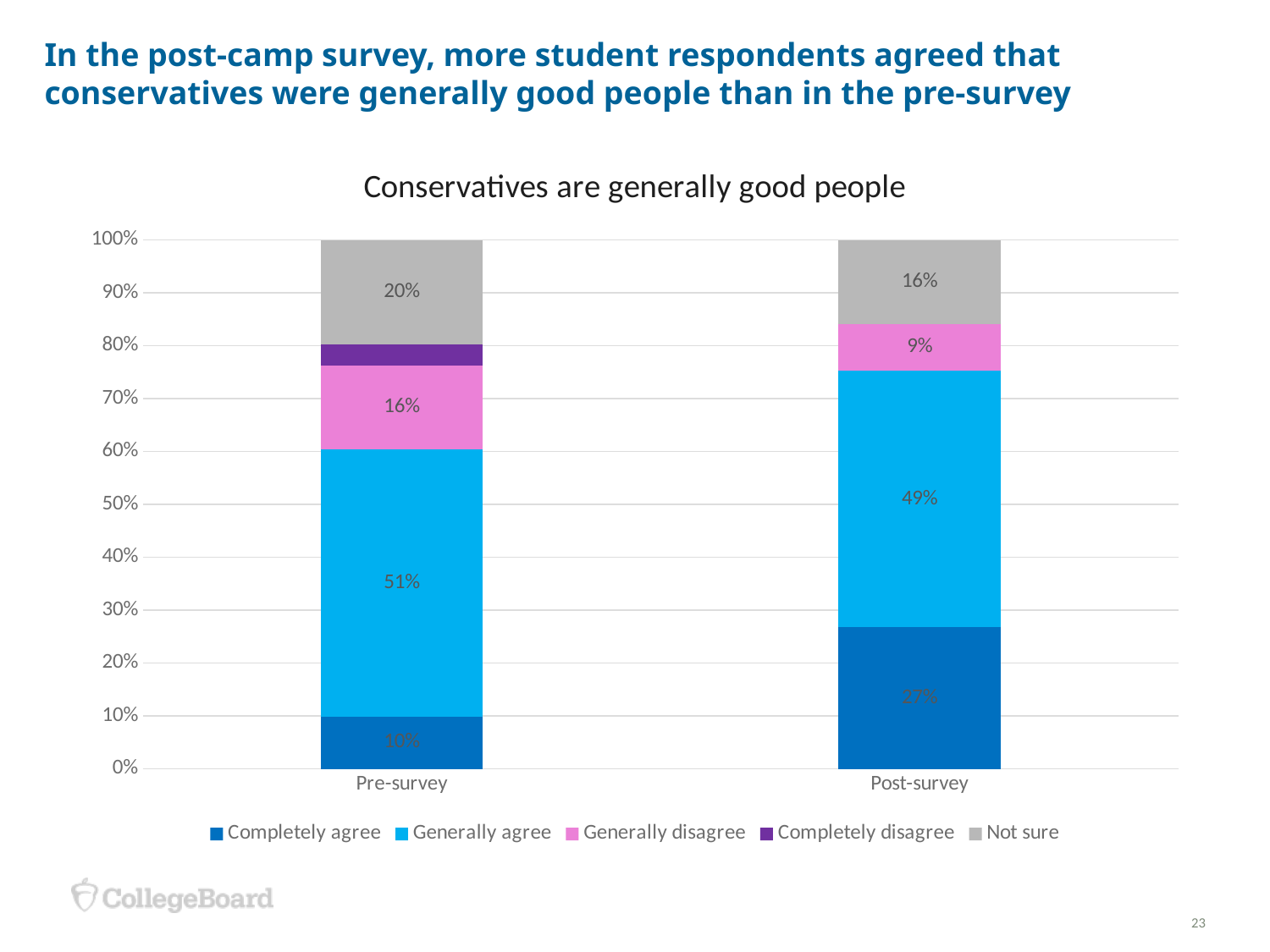
What is the title of the chart? Conservatives are generally good people What percentage of Pre-survey respondents chose 'Generally agree'? 51% What percentage of Post-survey respondents chose 'Completely agree'? 27% Is the 'Completely disagree' value for the Pre-survey greater or less than 10%? less What is the 'Not sure' value for the Pre-survey? 20% How many categories are shown on the x axis? 2 How many series does the legend list? 5 Which legend entry is shown in grey? Not sure What is the 'Generally disagree' value for the Post-survey? 9% What is the difference between the 'Completely agree' values for Post-survey and Pre-survey? 17% What type of chart is shown on the slide? Stacked bar chart Which survey has the larger 'Generally disagree' share, Pre-survey or Post-survey? Pre-survey